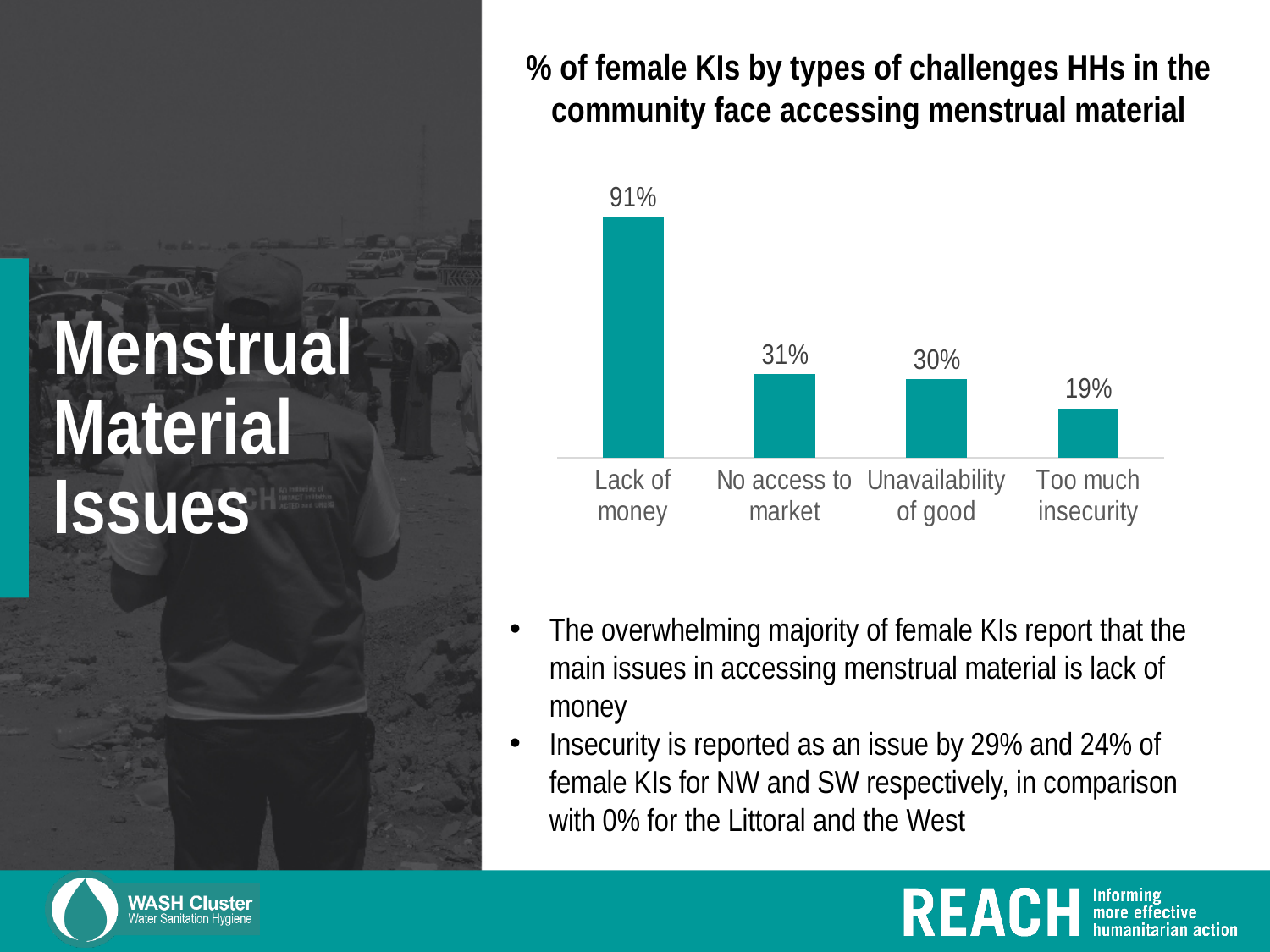
How many challenge categories are shown in the chart? 4 What type of chart is used on this slide? Bar chart Which challenge has the highest percentage of female KIs? Lack of money What is the value shown for 'Unavailability of good'? 30% Which challenge has the lowest percentage of female KIs? Too much insecurity What is the difference in percentage points between 'Lack of money' and 'Too much insecurity'? 72 What is the value shown for 'Too much insecurity'? 19% Which is larger: the value for 'Lack of money' or the value for 'No access to market'? Lack of money What percentage of female KIs reported lack of money as a challenge in accessing menstrual material? 91% What is the title of the chart? % of female KIs by types of challenges HHs in the community face accessing menstrual material What is the difference in percentage points between 'No access to market' and 'Unavailability of good'? 1 What is the value shown for 'No access to market'? 31%